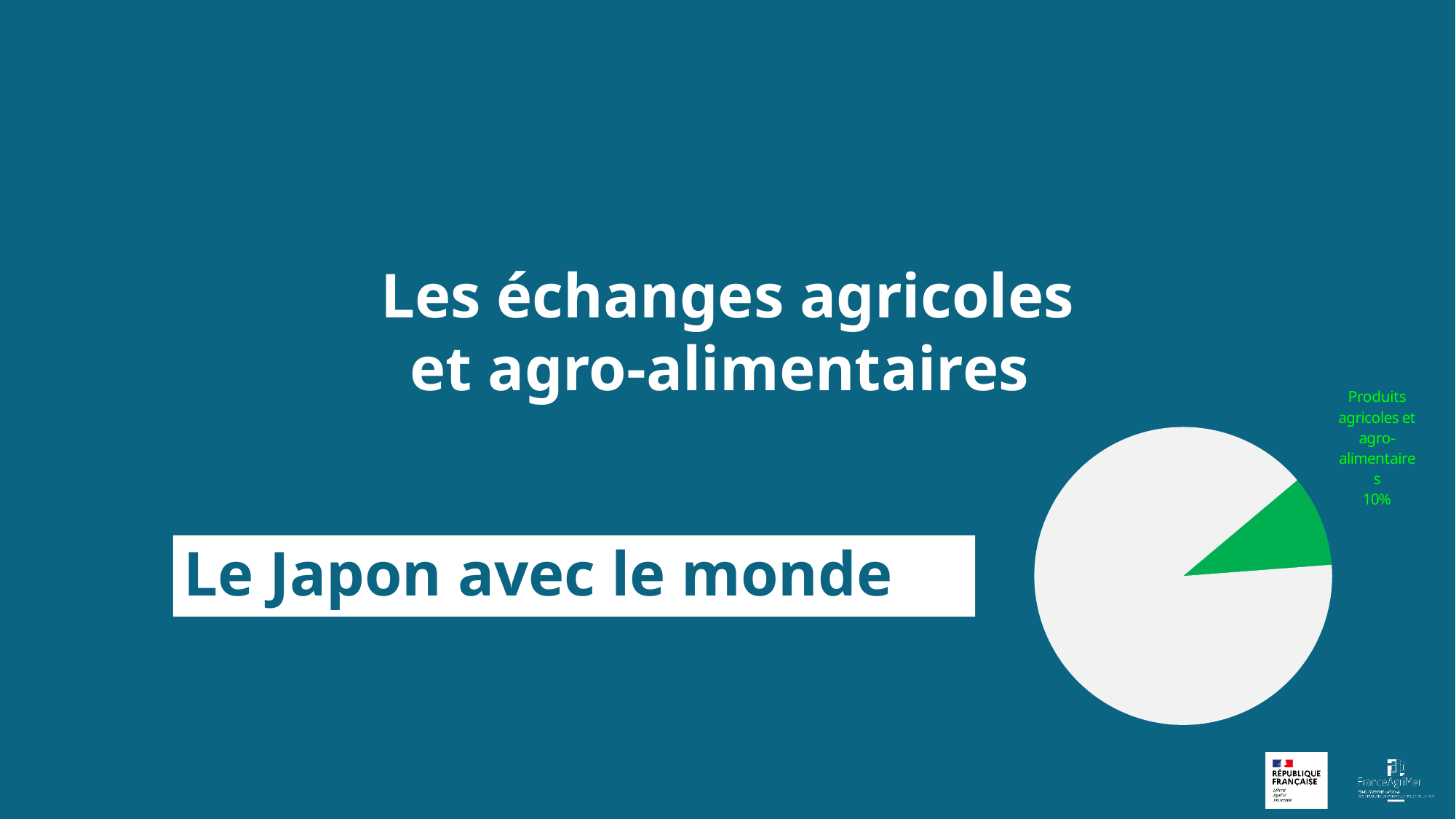
What share of the pie does the slice labelled "Produits agricoles et agro-alimentaires" represent? 10% Which slice of the pie chart is the smallest? Produits agricoles et agro-alimentaires Which slice of the pie chart is larger, the green labelled slice or the white unlabelled slice? The white unlabelled slice What colour is the slice labelled "Produits agricoles et agro-alimentaires"? Green How many slices does the pie chart contain? 2 Is the share of the slice labelled "Produits agricoles et agro-alimentaires" greater or less than 50%? less What kind of chart is shown on the right of the slide? Pie chart What percentage is printed next to the green slice of the pie chart? 10%